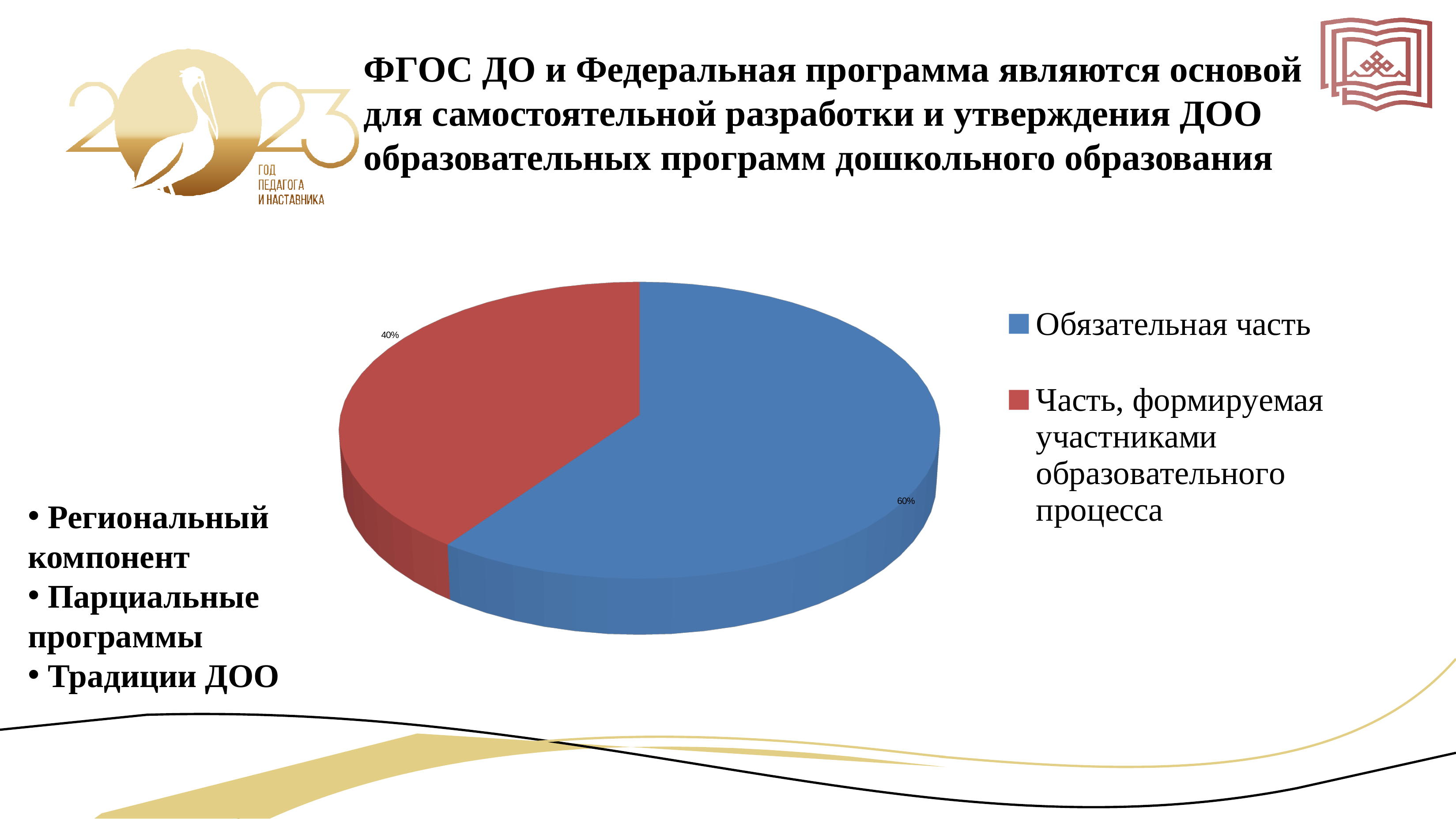
How many entries does the legend list? 2 What is the difference between the share of "Обязательная часть" and the share of "Часть, формируемая участниками образовательного процесса"? 20% What share of the pie does "Часть, формируемая участниками образовательного процесса" take? 40% Which is larger: the share of "Обязательная часть" or the share of "Часть, формируемая участниками образовательного процесса"? Обязательная часть What colour is the slice for "Часть, формируемая участниками образовательного процесса"? red What kind of chart is shown on the slide? pie chart What colour is the slice for "Обязательная часть"? blue How many slices does the pie chart have? 2 Which slice of the pie is the largest? Обязательная часть What share of the pie does "Обязательная часть" take? 60% Which slice of the pie is the smallest? Часть, формируемая участниками образовательного процесса